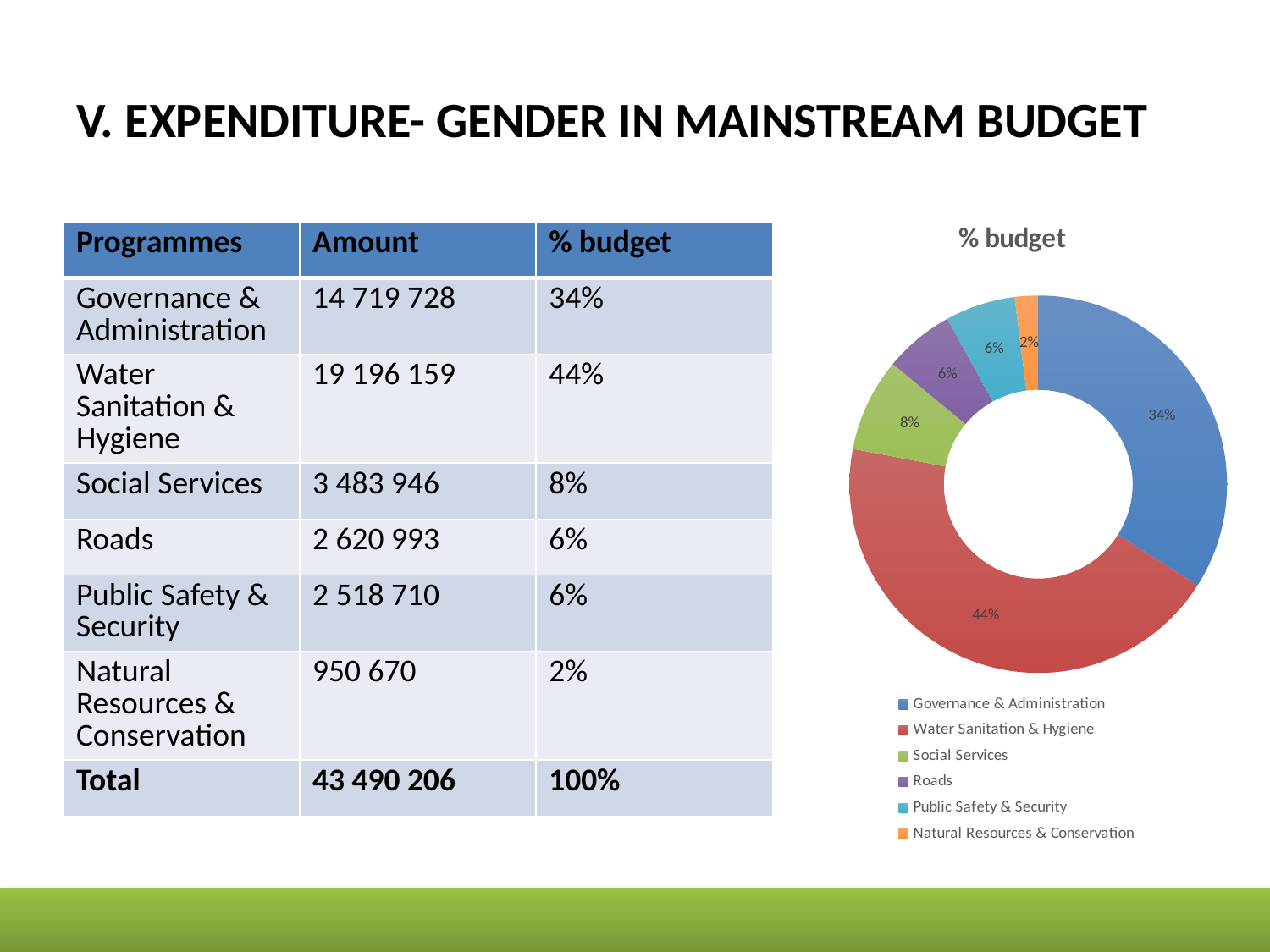
Which programme has the largest slice in the % budget chart? Water Sanitation & Hygiene What kind of chart is the % budget chart? Doughnut chart In the % budget chart, which slice is larger: Social Services or Roads? Social Services In the % budget chart, what share of the budget goes to Water Sanitation & Hygiene? 44% What is the title of the chart on the slide? % budget How many programme categories are plotted in the % budget chart? 6 In the % budget chart, what share is labelled for Social Services? 8% In the % budget chart, how many percentage points larger is the Water Sanitation & Hygiene slice than the Governance & Administration slice? 10 percentage points In the % budget chart, what colour is the Water Sanitation & Hygiene slice? Red In the % budget chart, what percentage is shown for Natural Resources & Conservation? 2% In the % budget chart, what percentage is shown for Governance & Administration? 34% Which programme has the smallest slice in the % budget chart? Natural Resources & Conservation